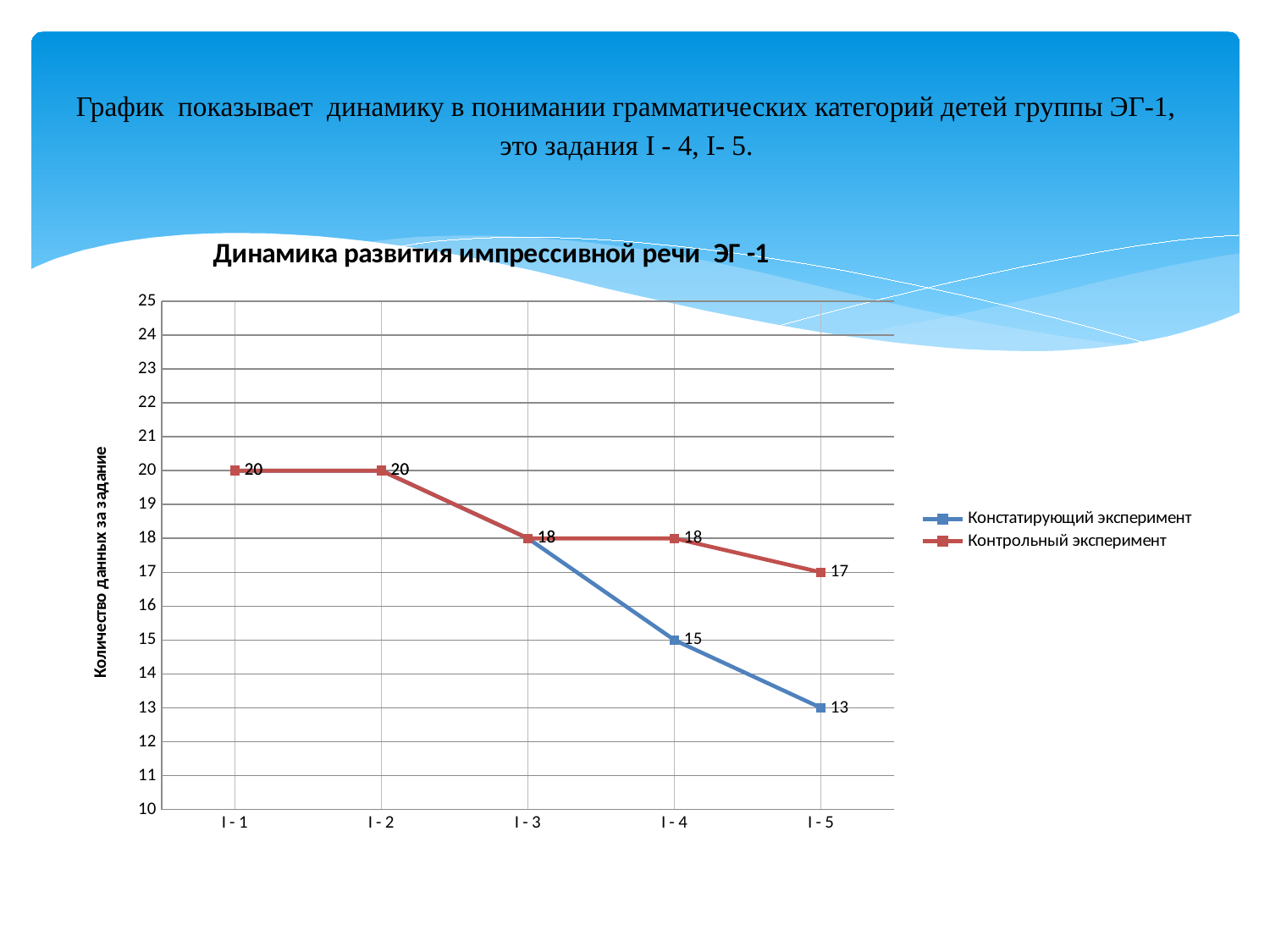
How many categories are shown on the x axis? 5 What is the value for Констатирующий эксперимент at I - 4? 15 What is the value for Контрольный эксперимент at I - 5? 17 What is the difference between Контрольный эксперимент and Констатирующий эксперимент at I - 5? 4 Which series has the larger value at I - 4? Контрольный эксперимент At which category is the value for Констатирующий эксперимент lowest? I - 5 Do the values for Констатирующий эксперимент rise or fall from I - 1 to I - 5? fall What type of chart is shown on the slide? line chart What is the title of the chart? Динамика развития импрессивной речи ЭГ -1 What is the value for Констатирующий эксперимент at I - 5? 13 What is the value for Контрольный эксперимент at I - 4? 18 How many series does the legend list? 2